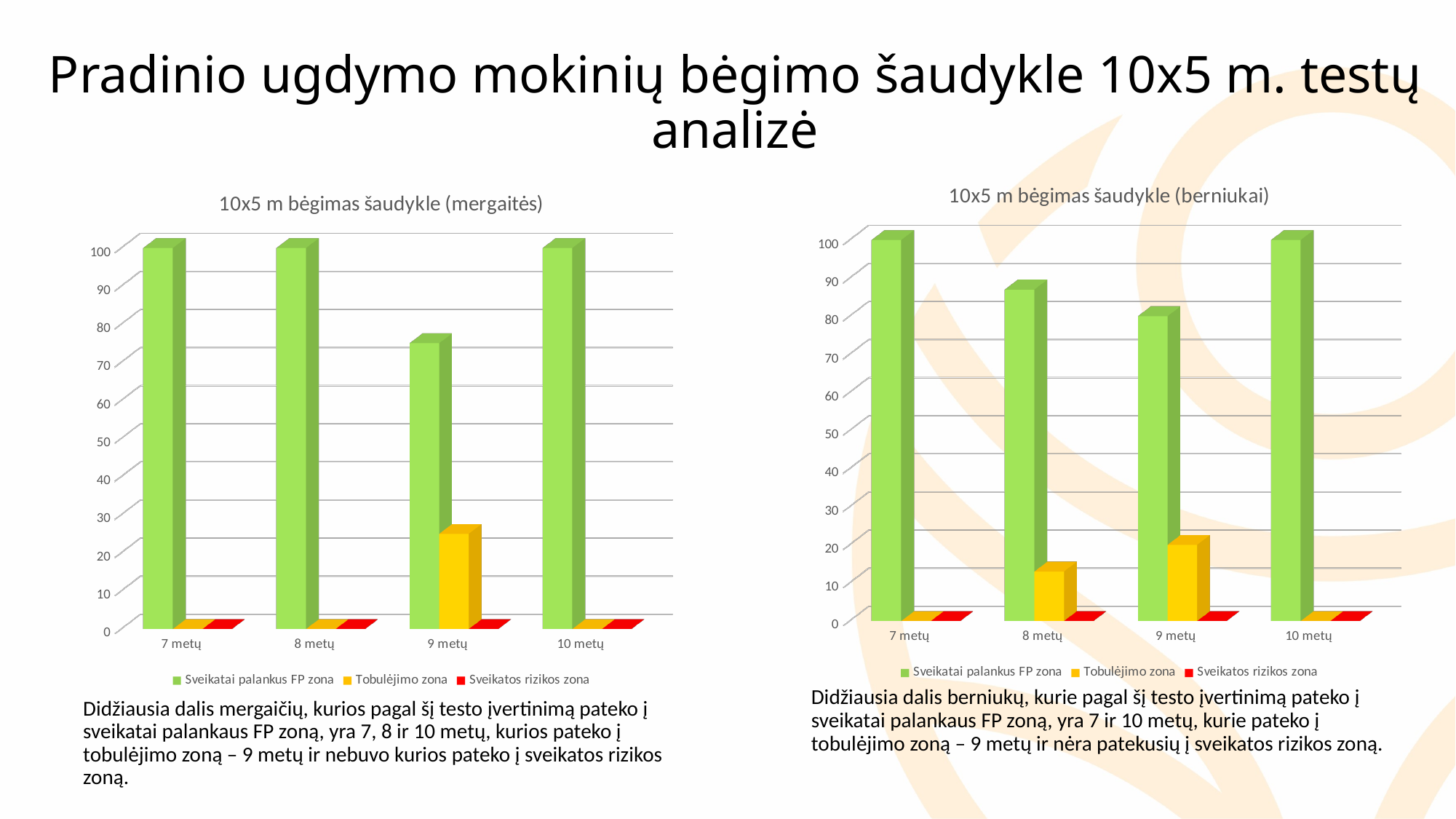
In the chart titled "10x5 m bėgimas šaudykle (berniukai)", how many series does the legend list? 3 In the chart titled "10x5 m bėgimas šaudykle (berniukai)", is the value of Sveikatai palankus FP zona for 8 metų greater or less than 80? greater In the chart titled "10x5 m bėgimas šaudykle (mergaitės)", is the value of Tobulėjimo zona for 9 metų greater or less than 20? greater In the chart titled "10x5 m bėgimas šaudykle (mergaitės)", how many age categories are shown on the x axis? 4 In the chart titled "10x5 m bėgimas šaudykle (berniukai)", what is the value of Sveikatai palankus FP zona for 10 metų? 100 In the chart titled "10x5 m bėgimas šaudykle (berniukai)", which is larger for Tobulėjimo zona: 8 metų or 9 metų? 9 metų In the chart titled "10x5 m bėgimas šaudykle (mergaitės)", which colour represents Sveikatos rizikos zona? red In the chart titled "10x5 m bėgimas šaudykle (mergaitės)", what kind of chart is shown? bar chart In the chart titled "10x5 m bėgimas šaudykle (mergaitės)", which age group has the lowest value for Sveikatai palankus FP zona? 9 metų In the chart titled "10x5 m bėgimas šaudykle (mergaitės)", what is the value of Sveikatai palankus FP zona for 7 metų? 100 In the chart titled "10x5 m bėgimas šaudykle (berniukai)", is the value of Tobulėjimo zona for 8 metų greater or less than 20? less In the chart titled "10x5 m bėgimas šaudykle (berniukai)", which age group has the lowest value for Sveikatai palankus FP zona? 9 metų